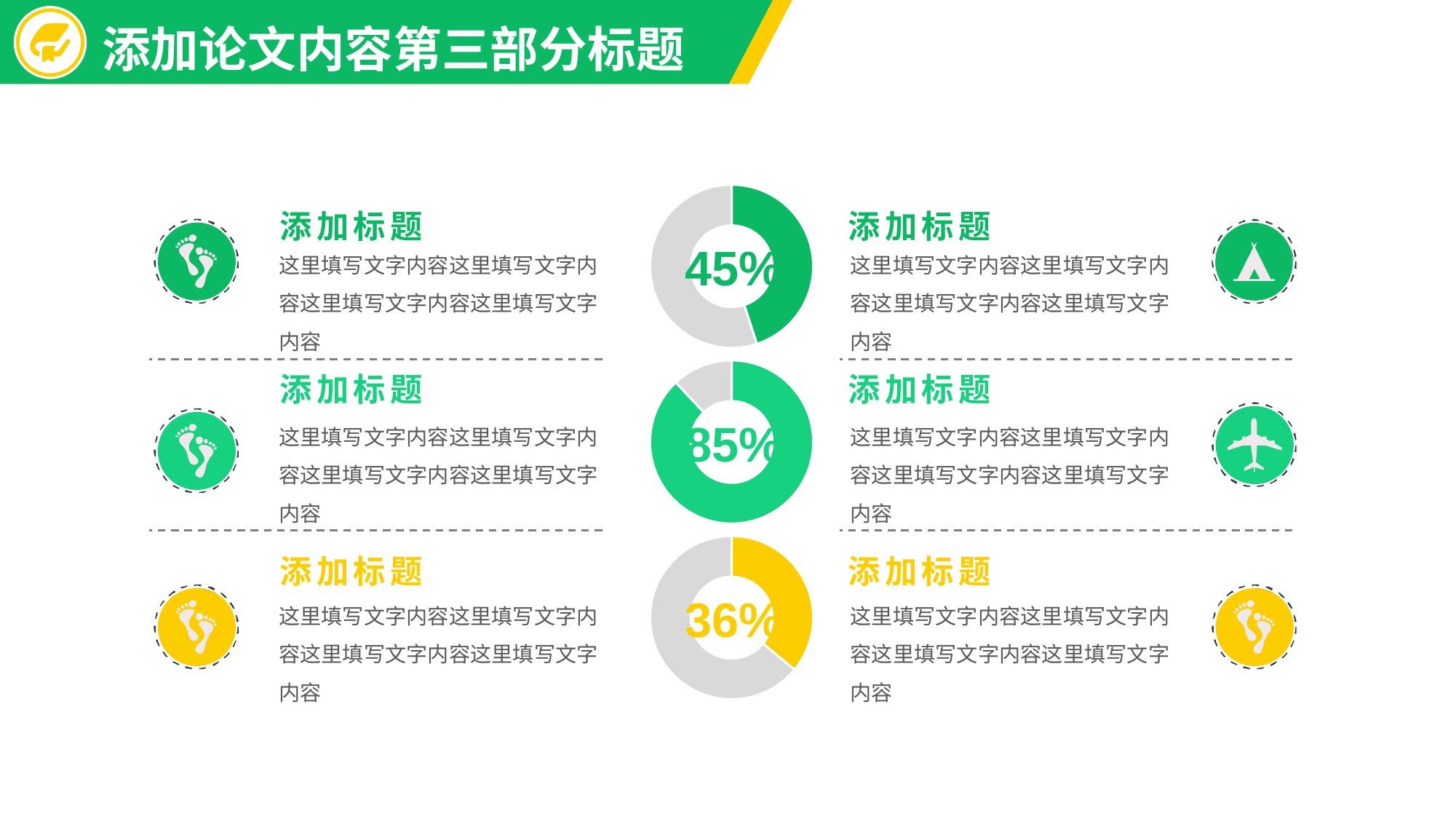
What percentage is shown in the centre of the bottom donut chart? 36% What is the difference between the percentage in the middle donut chart and the percentage in the top donut chart? 40 percentage points What colour is the filled segment of the bottom donut chart? Yellow What is the difference between the percentage in the top donut chart and the percentage in the bottom donut chart? 9 percentage points What percentage is shown in the centre of the top donut chart? 45% Which shows a larger percentage, the top donut chart or the bottom donut chart? The top donut chart (45%) What kind of charts are shown in the centre column of the slide? Donut (pie) charts What percentage is shown in the centre of the middle donut chart? 85% Which donut chart shows the lowest percentage? The bottom one (36%) Which donut chart shows the highest percentage? The middle one (85%) How many donut charts are on the slide? 3 What colour is the filled segment of the middle donut chart? Green